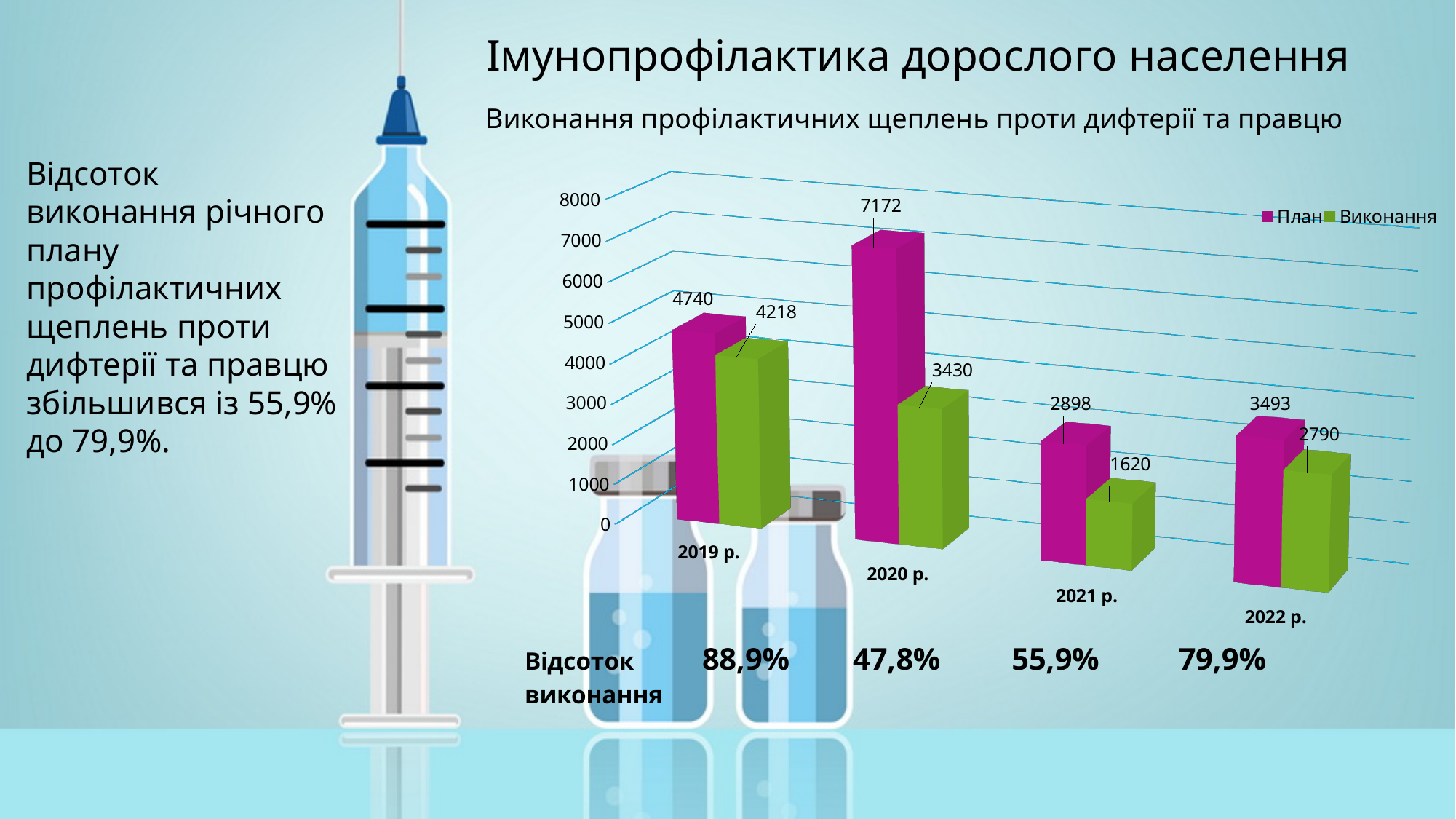
What is the value of План for 2020 р.? 7172 What is the value of Виконання for 2019 р.? 4218 What kind of chart is shown? bar chart What is the value of Виконання for 2021 р.? 1620 Which year has the highest План value? 2020 р. How many years are shown on the x axis? 4 Which year has the lowest Виконання value? 2021 р. Which is larger in 2022 р., План or Виконання? План Is the value of План for 2021 р. greater or less than 3000? less Which series is shown in green in the legend? Виконання How many series does the legend list? 2 What is the difference between План and Виконання in 2020 р.? 3742